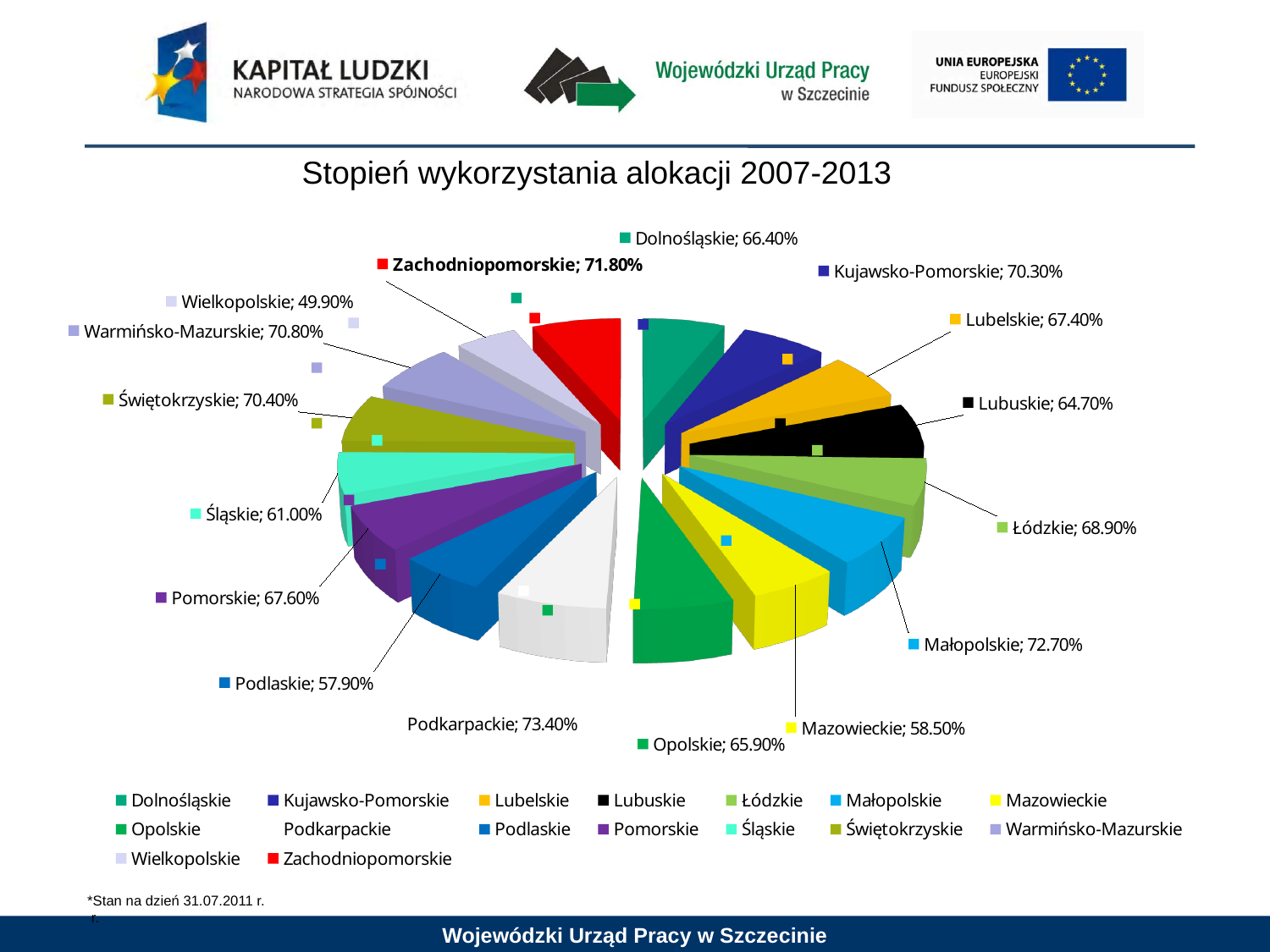
What type of chart is shown on the slide? Pie chart What is the value shown for Mazowieckie? 58.50% What is the value shown for Zachodniopomorskie? 71.80% Which region has the highest value in the chart? Podkarpackie What is the value shown for Małopolskie? 72.70% What is the value shown for Wielkopolskie? 49.90% What is the difference between the values for Zachodniopomorskie and Podlaskie? 13.90 percentage points Which has a larger value, Lubelskie or Lubuskie? Lubelskie How many regions are shown in the pie chart? 16 What is the title of the chart? Stopień wykorzystania alokacji 2007-2013 Which region has the lowest value in the chart? Wielkopolskie What is the difference between the values for Podkarpackie and Wielkopolskie? 23.50 percentage points